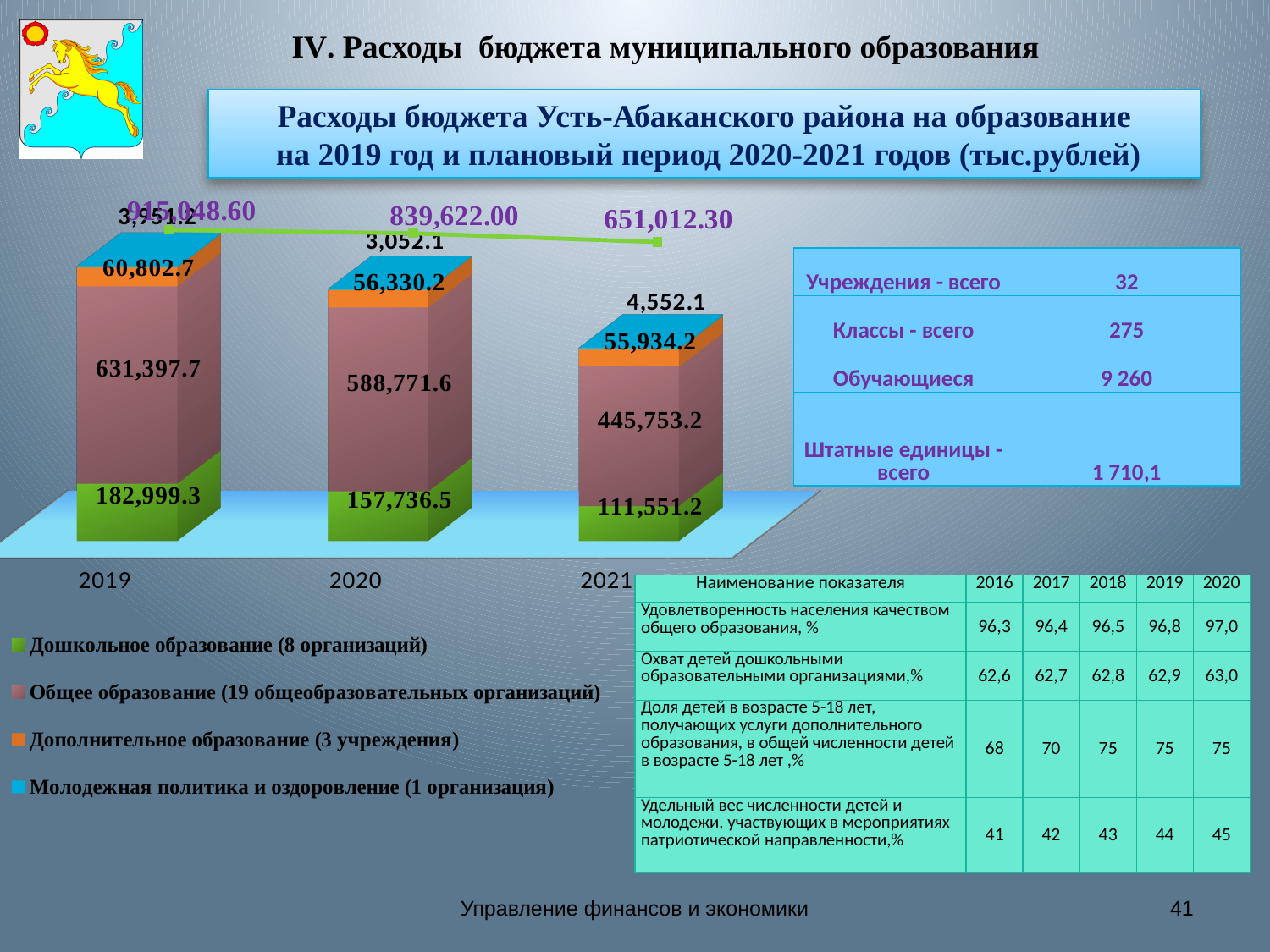
In which year is the value for Дошкольное образование the lowest? 2021 What is the value for Молодежная политика и оздоровление in 2020? 3,052.1 What kind of chart is used to show the education expenditures? stacked bar chart What is the value for Общее образование in 2020? 588,771.6 Which year has the larger value for Дополнительное образование, 2019 or 2020? 2019 What is the value for Дошкольное образование in 2019? 182,999.3 In which year is the value for Общее образование the highest? 2019 How many series does the chart legend list? 4 What is the difference between the Общее образование values for 2019 and 2021? 185,644.5 What is the value for Дополнительное образование in 2021? 55,934.2 How many years are shown on the x axis of the chart? 3 What is the total of the stacked bar for 2021? 617,790.7